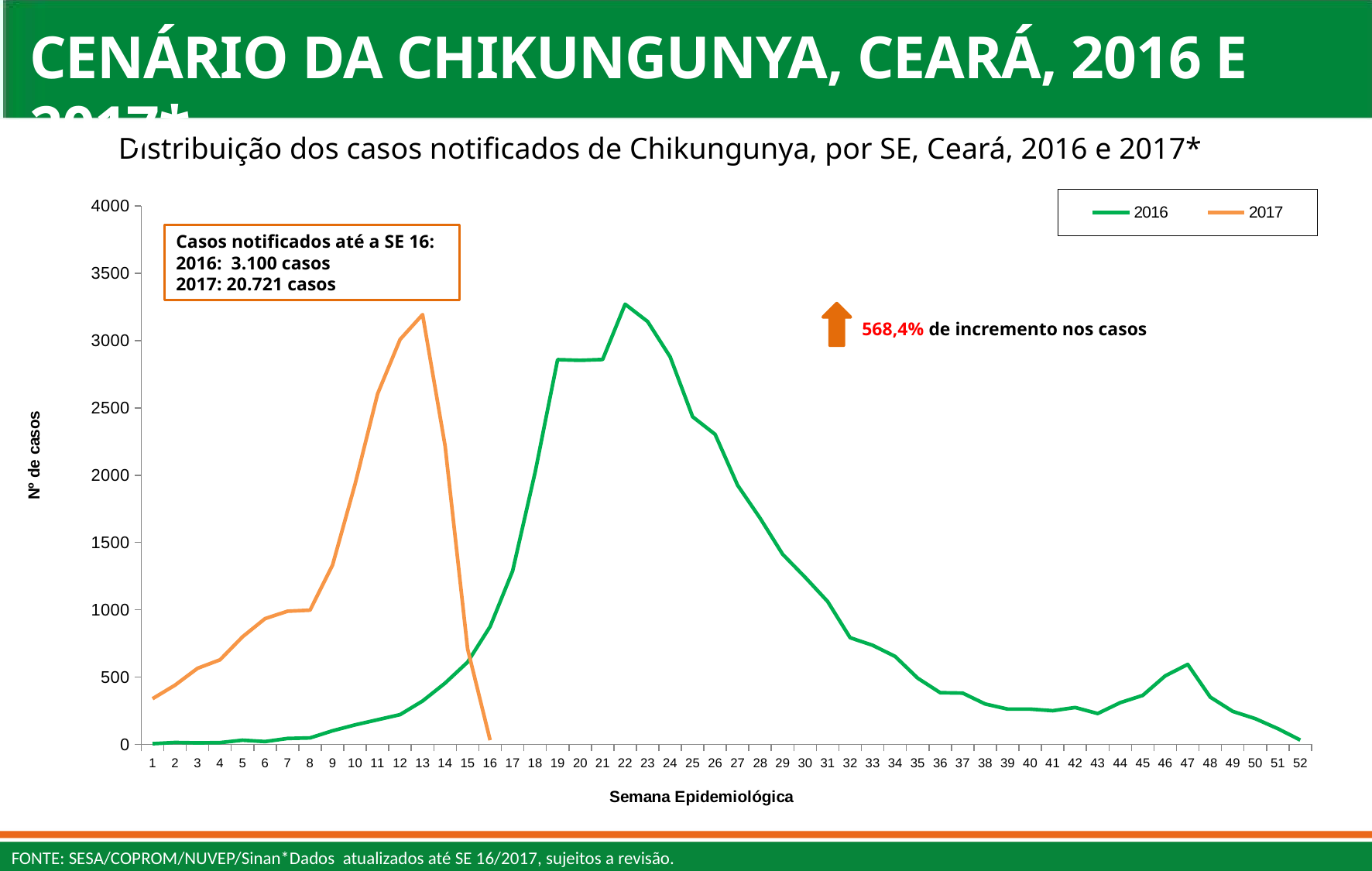
How many epidemiological weeks are shown on the x axis? 52 What kind of chart is shown on the slide? Line chart According to the text box, how many cases were notified up to SE 16 in 2017? 20.721 casos Which series has the larger value in week 13, 2016 or 2017? 2017 Is the value for 2016 in week 1 greater or less than 500? less In which epidemiological week does the 2016 series reach its highest value? 22 How many series does the legend list? 2 In which epidemiological week does the 2017 series reach its highest value? 13 Is the value for 2017 in week 16 greater or less than 500? less Which colour represents the 2016 series in the legend? Green Is the value for 2017 in week 13 greater or less than 3000? greater Does the 2017 series rise or fall from week 1 to week 13? rise